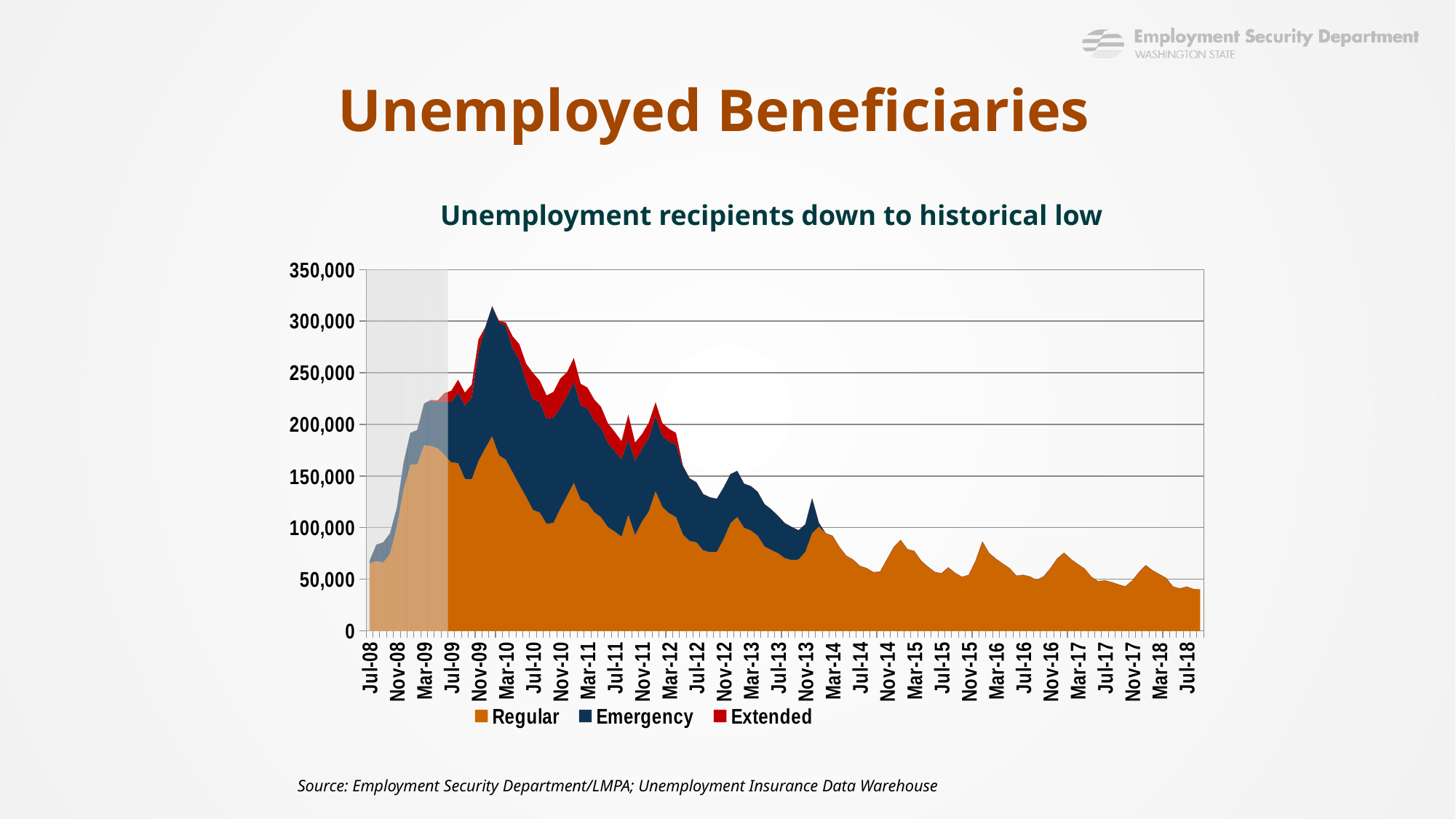
What are the three series named in the chart legend? Regular, Emergency, Extended What is the title of the chart? Unemployment recipients down to historical low Is the peak total number of beneficiaries around early 2010 greater or less than 300,000? greater Which series is larger at Nov-09, Regular or Emergency? Regular Is the total number of beneficiaries at Jul-14 greater or less than 100,000? less What kind of chart is shown on the slide? Stacked area chart Which series is the only one still present in the chart from 2015 onward? Regular Is the value for Regular beneficiaries at Jul-08 greater or less than 100,000? less Overall, do the total beneficiary values rise or fall from early 2010 to Jul-18? fall How many series does the chart legend list? 3